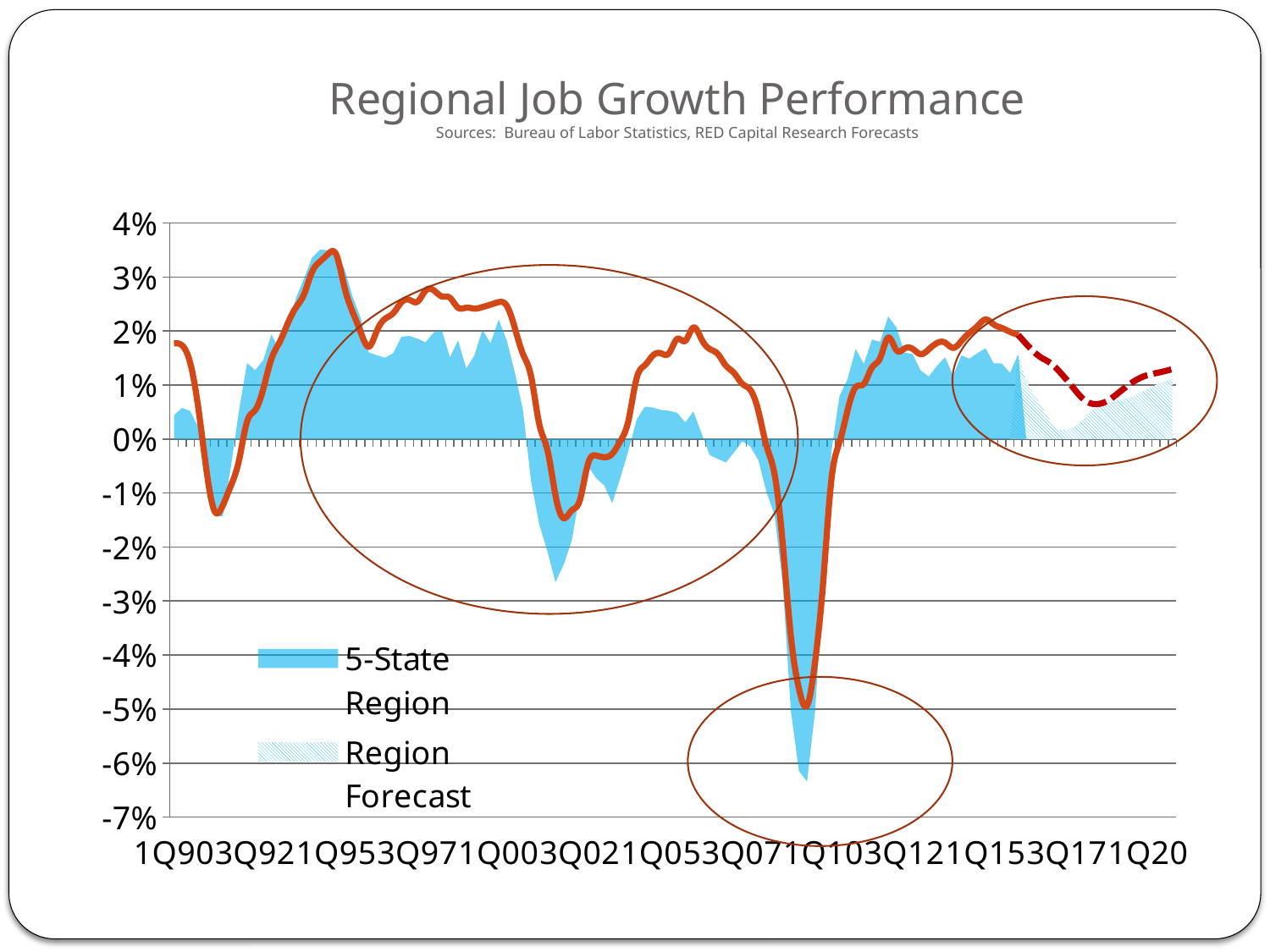
What is the title of the chart? Regional Job Growth Performance What are the two series named in the legend? 5-State Region and Region Forecast Which is larger for the 5-State Region series: the peak near 1Q95 or the peak near 3Q12? The peak near 1Q95 What is the lowest value shown on the vertical axis? -7% How many series does the legend list? 2 What kind of chart is this? Combination area and line chart Does the 5-State Region series rise or fall between 3Q07 and 1Q10? Fall Is the peak value of the 5-State Region series near 1Q95 greater or less than 3%? greater Is the 5-State Region value at 1Q90 greater or less than 1%? less Around which x-axis label does the 5-State Region series reach its lowest point? 1Q10 Is the lowest value of the 5-State Region series, near 1Q10, greater or less than -5%? less